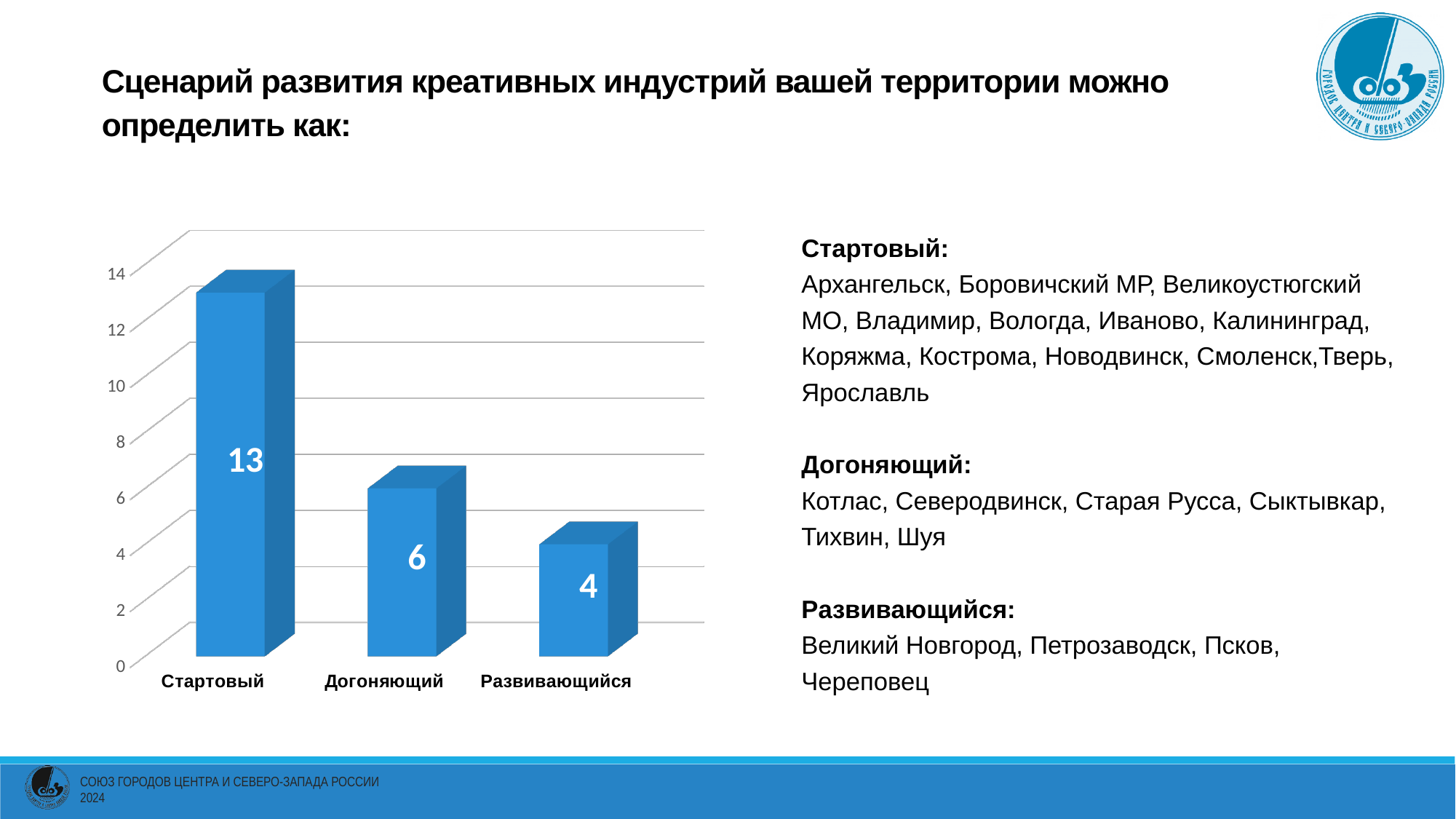
What is the value for Догоняющий? 6 How many categories are shown on the chart? 3 Is the value for Стартовый greater or less than 10? greater What is the value for Развивающийся? 4 Which is larger, the value for Догоняющий or the value for Развивающийся? Догоняющий What is the difference between the values for Догоняющий and Развивающийся? 2 Do the values rise or fall from left to right along the x axis? fall What kind of chart is shown on the slide? bar chart What is the difference between the values for Стартовый and Догоняющий? 7 What is the value for Стартовый? 13 Which category has the lowest value? Развивающийся Which category has the highest value? Стартовый